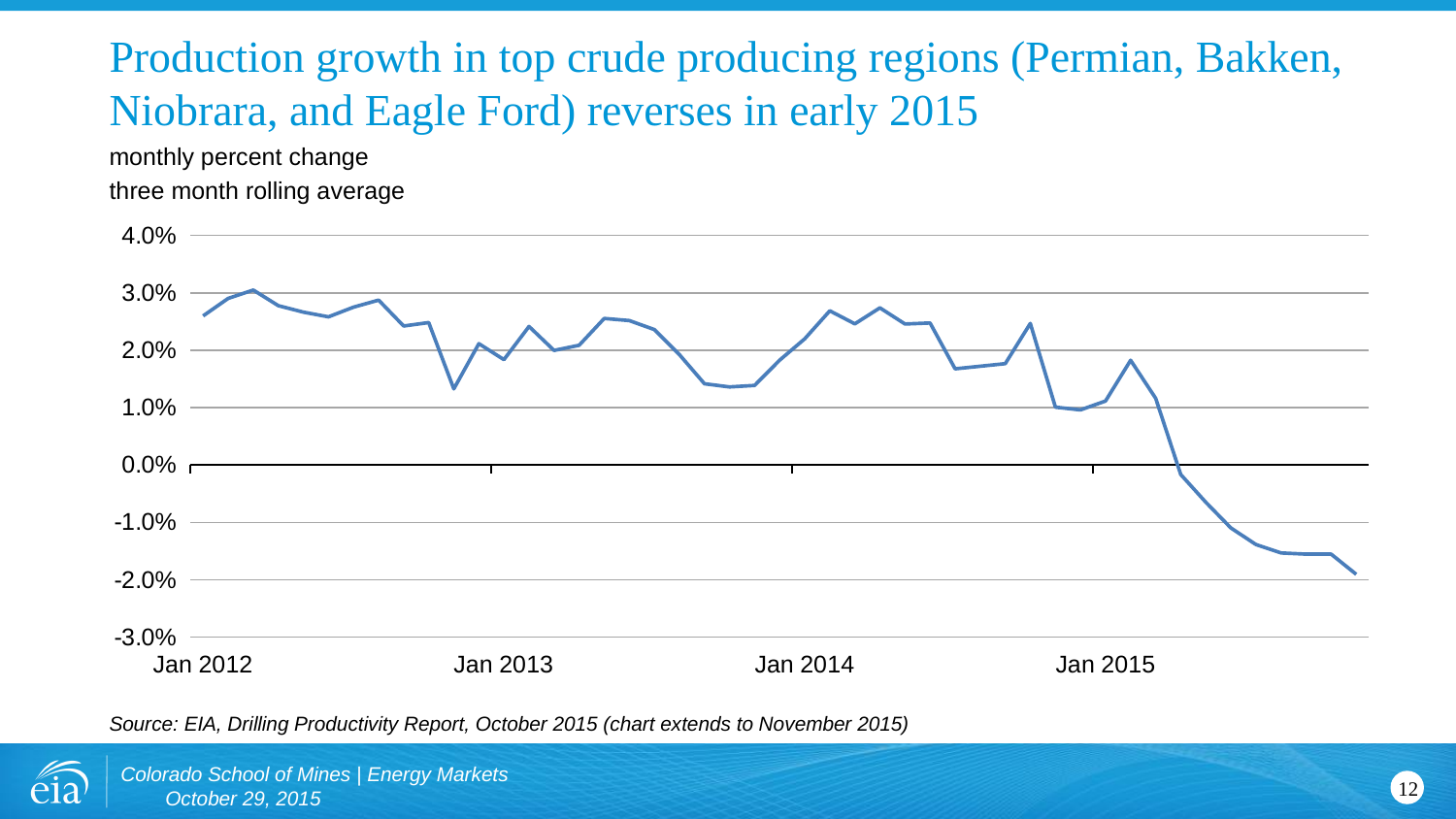
Does the line drop below 0.0% at any point on the chart? yes Is the value at Jan 2014 greater or less than 1.0%? greater Is the value at Jan 2015 greater or less than 2.0%? less What unit or measure does the chart's subtitle say the y axis shows? monthly percent change, three month rolling average How many year labels are shown on the x axis? 4 What kind of chart is shown on the slide? line chart Does the line rise or fall overall from Jan 2012 to the end of the chart? fall What is the title of the chart on the slide? Production growth in top crude producing regions (Permian, Bakken, Niobrara, and Eagle Ford) reverses in early 2015 How many lines are plotted on the chart? 1